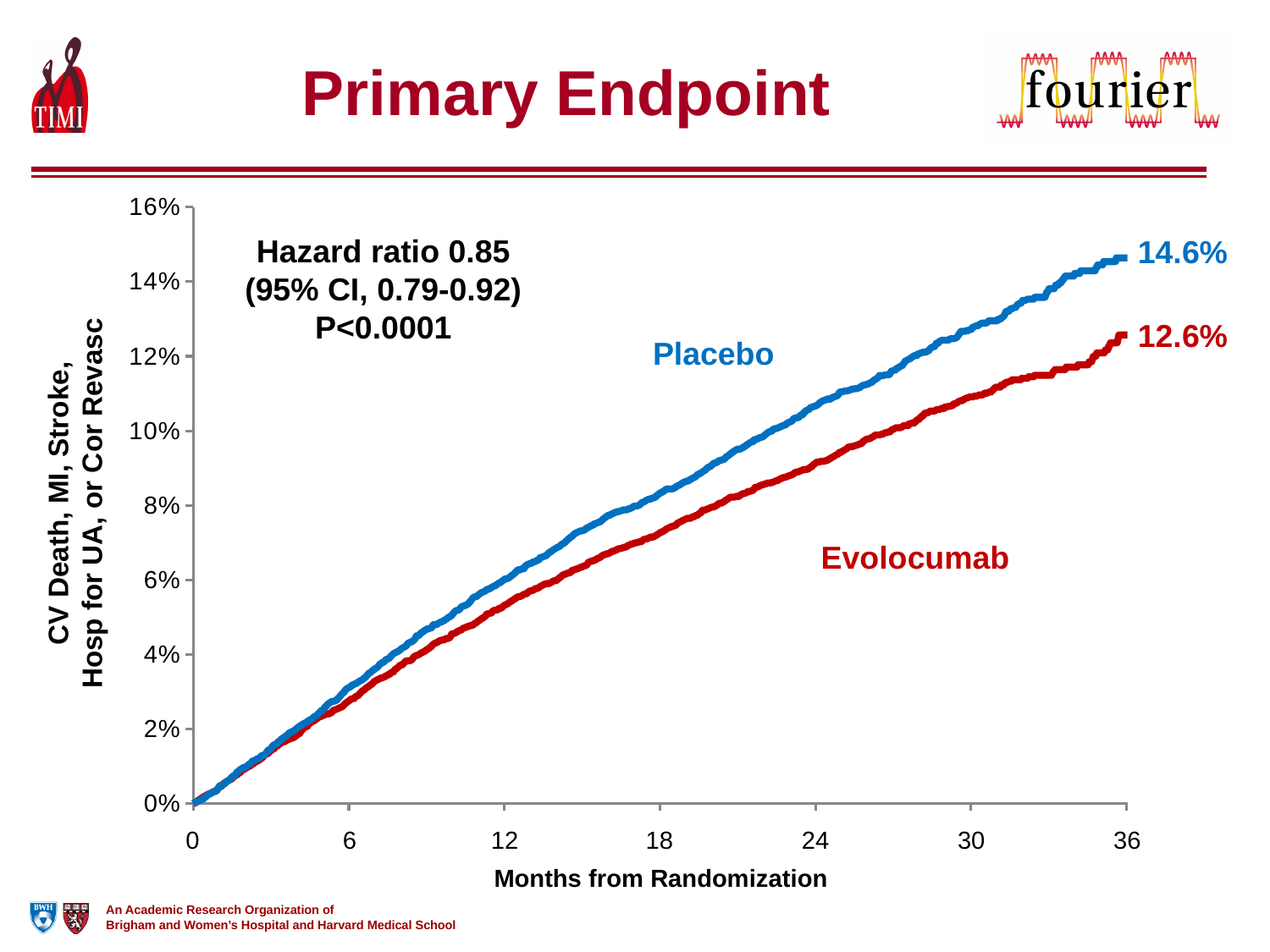
What is the difference between the final Placebo value and the final Evolocumab value? 2.0% Do the curves rise or fall as months from randomization increase? Rise How many treatment groups are plotted on the chart? 2 Is the value for Evolocumab at 12 months greater or less than 6%? less Which curve ends at the lower value at 36 months? Evolocumab Is the value for Evolocumab at 24 months greater or less than 10%? less Is the value for Evolocumab at 30 months greater or less than 10%? greater What is the final value shown for the Placebo curve at 36 months? 14.6% What kind of chart is shown on the slide? Line chart What is the final value shown for the Evolocumab curve at 36 months? 12.6% Which group has the higher event rate at 36 months, Placebo or Evolocumab? Placebo What hazard ratio is reported on the chart? 0.85